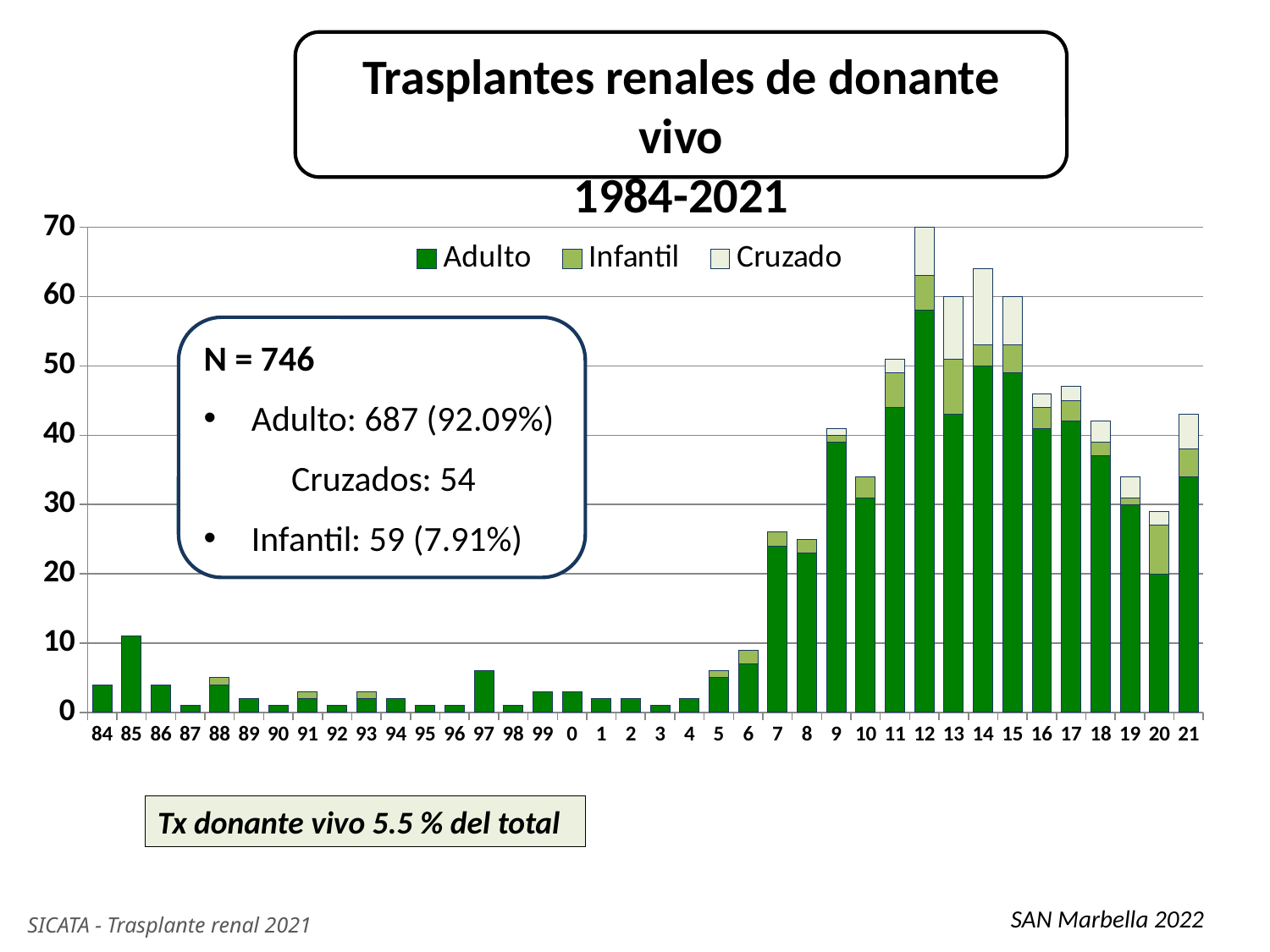
What are the three series named in the legend? Adulto, Infantil, Cruzado Is the total bar for year 11 greater or less than 40? greater What kind of chart is shown on the slide? Stacked bar chart Is the total bar for year 16 greater or less than 50? less Which total bar is taller, year 9 or year 10? 9 Do the total bars generally rise or fall from year 5 to year 12? rise Which total bar is taller, year 12 or year 14? 12 Is the total bar for year 8 greater or less than 30? less How many series does the legend list? 3 How many years (categories) are shown along the x axis? 38 Which year has the highest total bar? 12